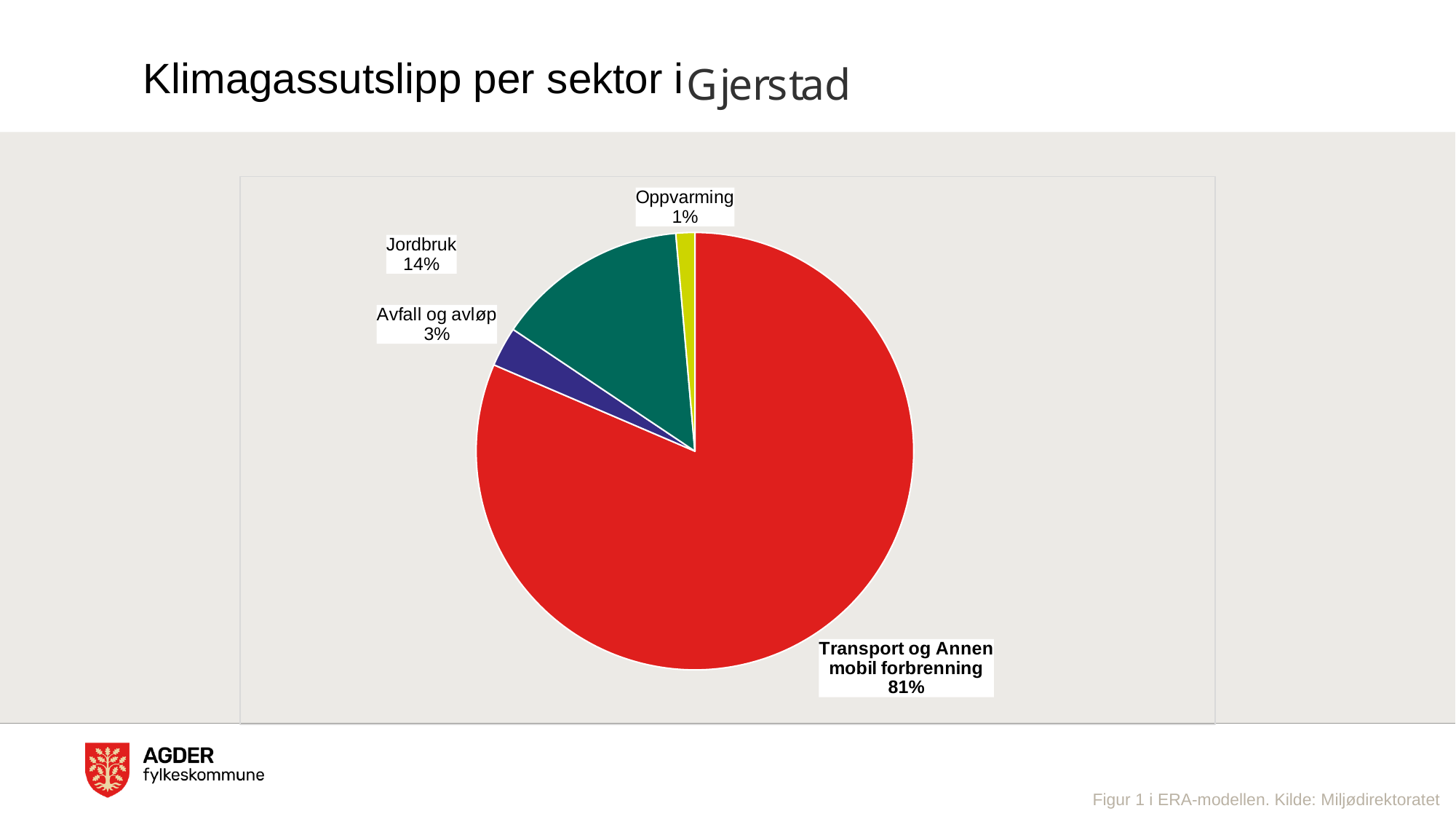
Which sector has the largest slice of the pie? Transport og Annen mobil forbrenning Which sector has the smallest slice of the pie? Oppvarming What share of the pie does Oppvarming have? 1% How many sectors are shown in the pie chart? 4 What colour is the slice for Jordbruk? green Which is larger, the share for Jordbruk or the share for Avfall og avløp? Jordbruk What share of the pie does Transport og Annen mobil forbrenning have? 81% What is the title of the slide? Klimagassutslipp per sektor i Gjerstad What is the difference in percentage points between Jordbruk and Avfall og avløp? 11 What kind of chart is shown on the slide? pie chart What share of the pie does Jordbruk have? 14%